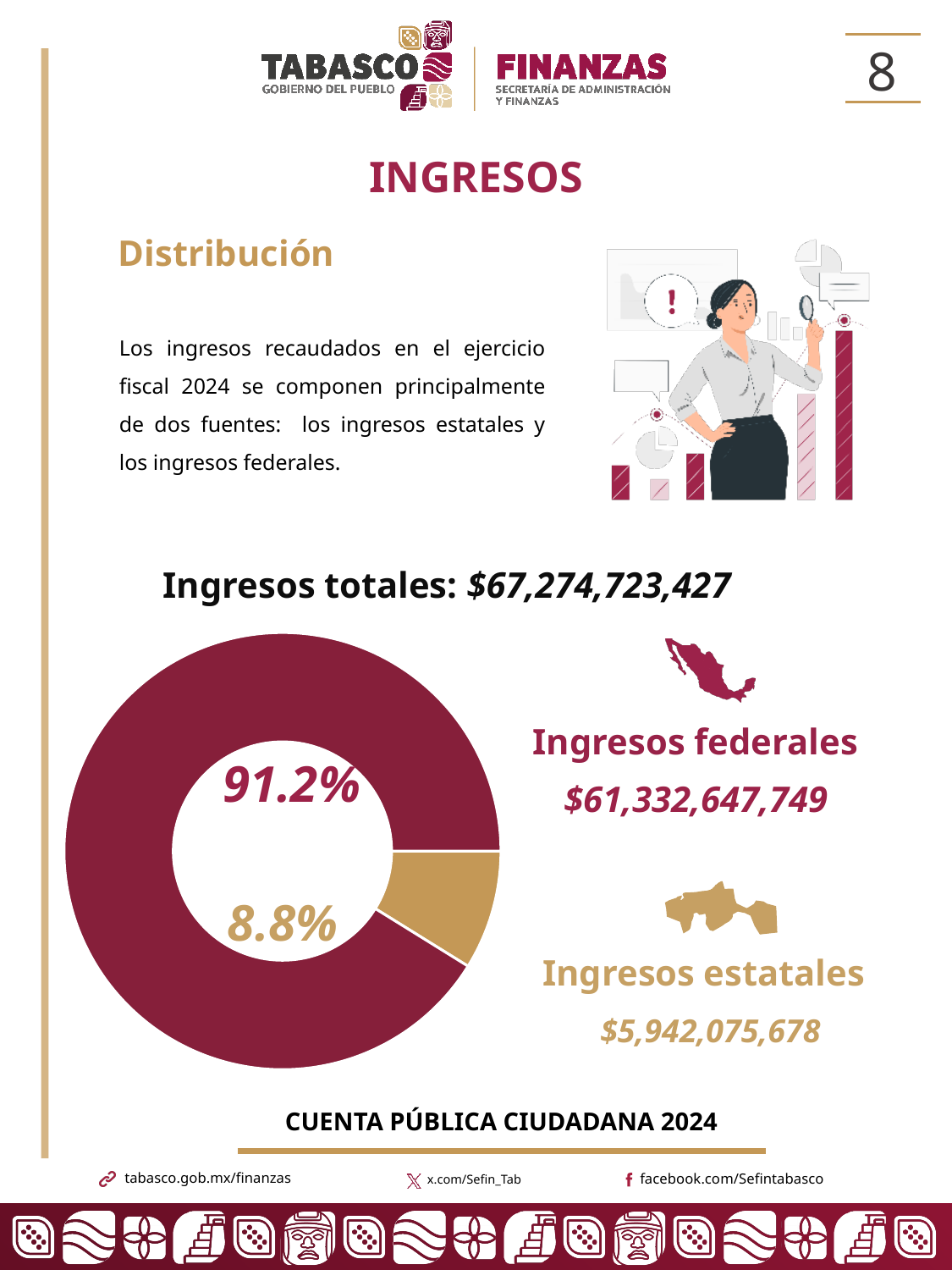
What is the difference in percentage points between the federal and state income shares? 82.4 percentage points What are the total income (Ingresos totales) shown on the slide? $67,274,723,427 Which category has the smallest share of the pie? Ingresos estatales What share of total income do Ingresos estatales represent? 8.8% Which is larger, Ingresos federales or Ingresos estatales? Ingresos federales How many categories does the pie chart show? 2 What is the value of Ingresos estatales? $5,942,075,678 Which category has the largest share of the pie? Ingresos federales What share of total income do Ingresos federales represent? 91.2% What kind of chart is shown on the slide? Pie chart (donut) What colour is the Ingresos estatales slice? Gold What is the value of Ingresos federales? $61,332,647,749